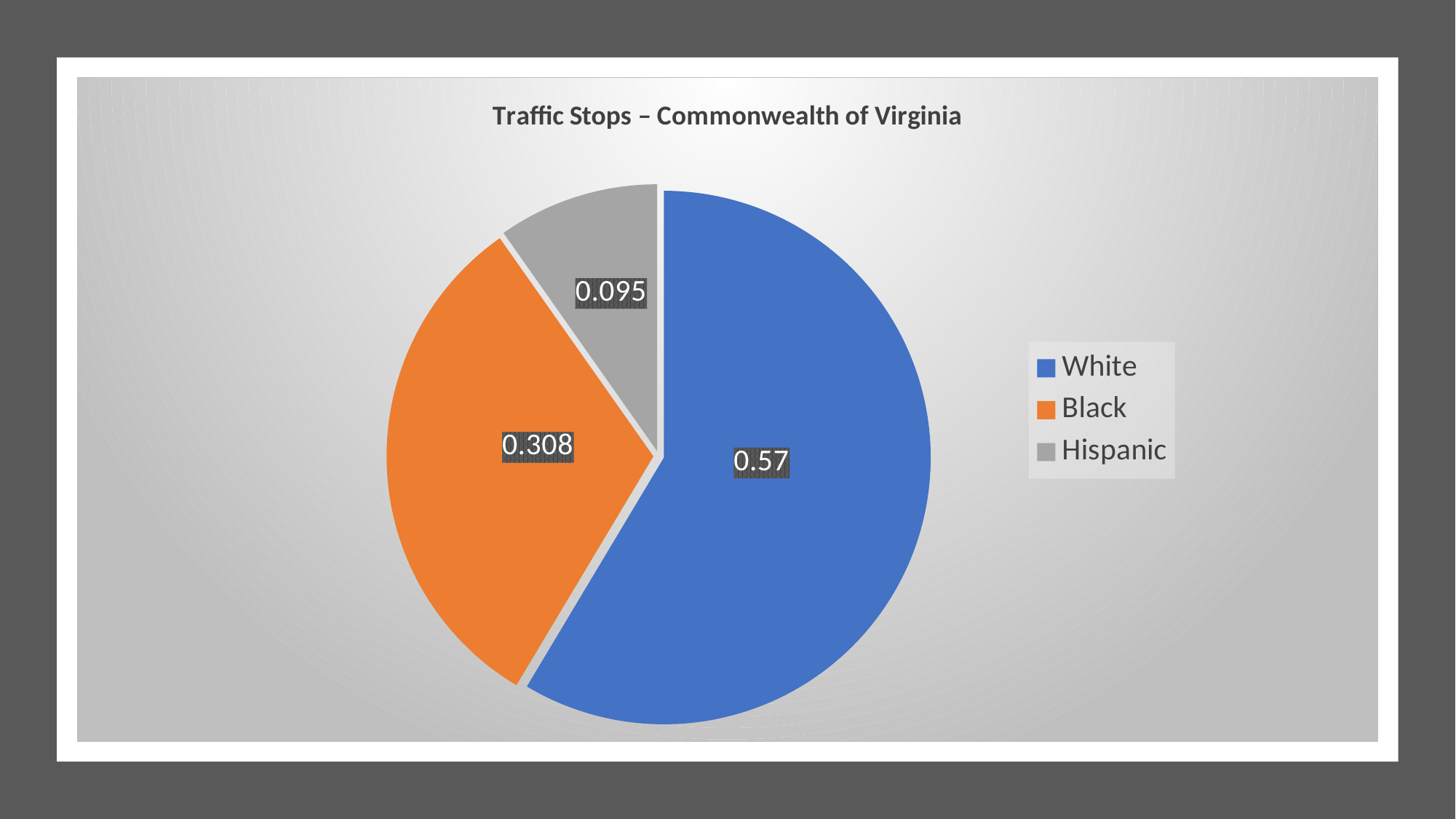
Which category has the largest slice? White How many slices does the pie chart have? 3 What is the difference between the values for White and Black? 0.262 What is the difference between the values for Black and Hispanic? 0.213 What is the title of the chart? Traffic Stops – Commonwealth of Virginia What is the value for White? 0.57 What kind of chart is shown on the slide? Pie chart Which is larger, the value for Black or the value for Hispanic? Black Which category has the smallest slice? Hispanic What is the value for Black? 0.308 Which colour represents Black in the legend? Orange What is the value for Hispanic? 0.095